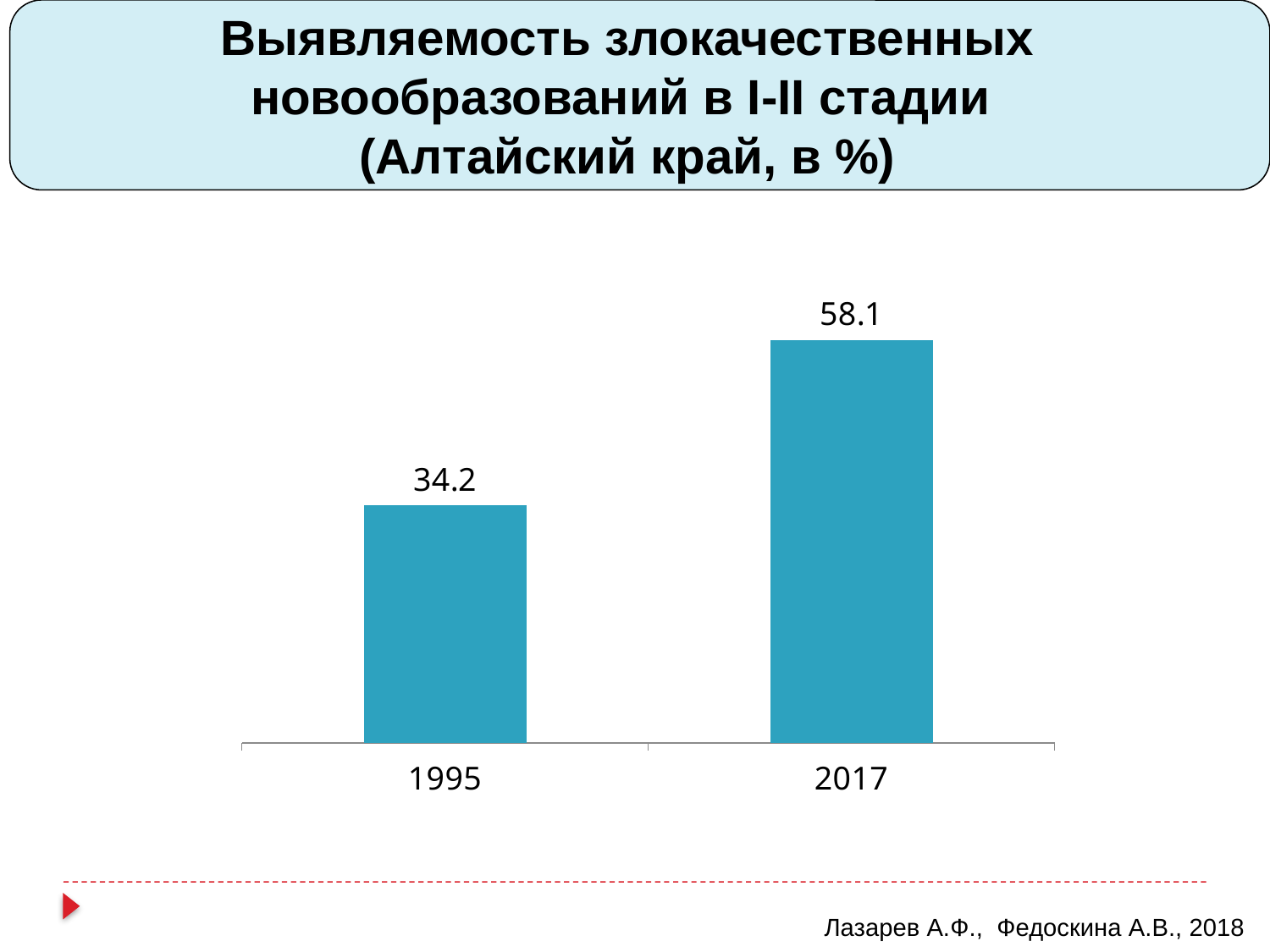
What is the title of the chart? Выявляемость злокачественных новообразований в I-II стадии (Алтайский край, в %) What colour are the bars in the chart? Blue Which year has the higher value? 2017 How many categories are shown on the x axis? 2 What is the value for 1995? 34.2 Which year has the lower value? 1995 Do the values rise or fall from 1995 to 2017? Rise Is the value for 2017 larger than the value for 1995? Yes What is the value for 2017? 58.1 What is the difference between the values for 2017 and 1995? 23.9 What kind of chart is shown on the slide? Bar chart